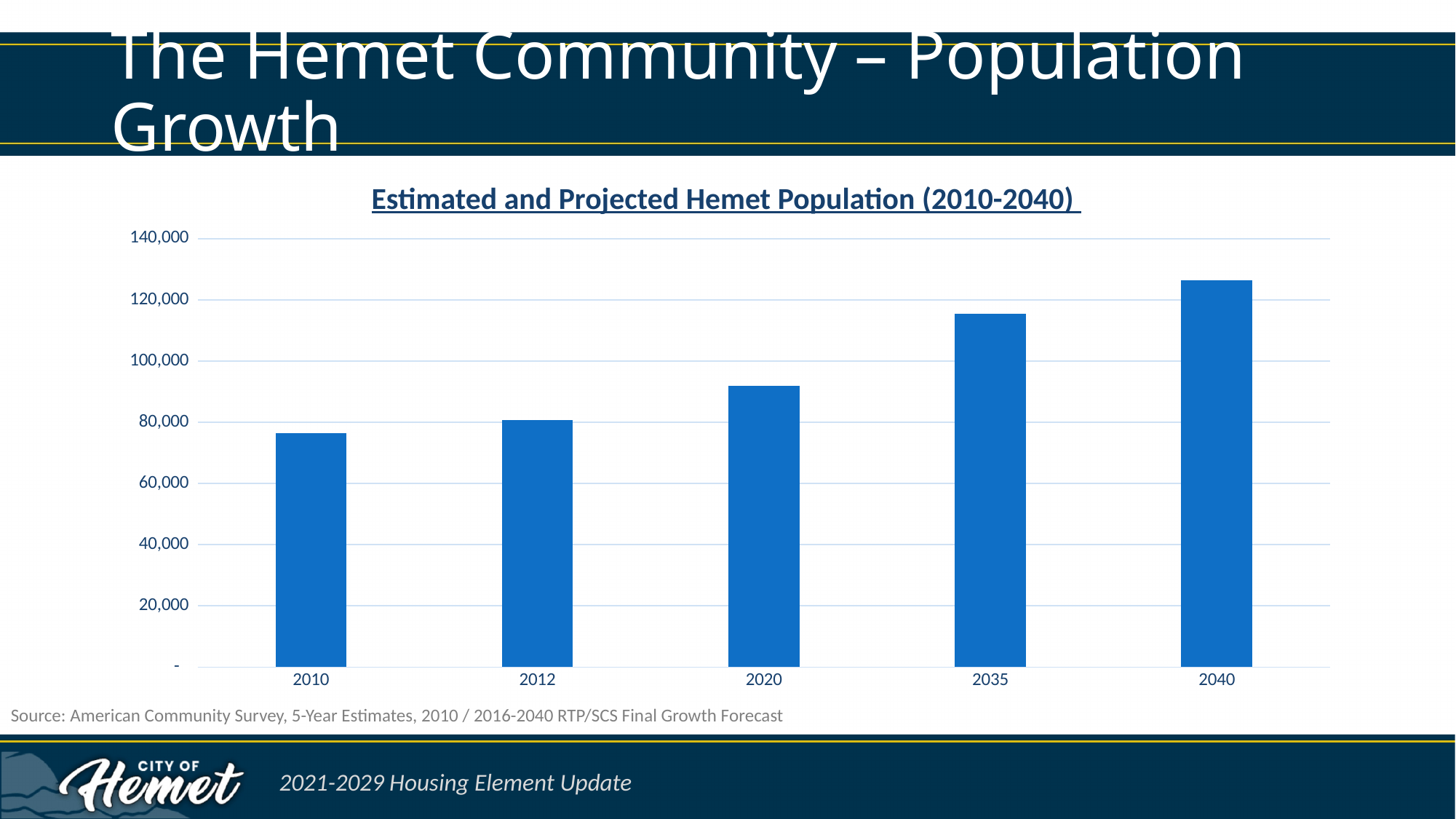
What type of chart is shown on the slide? Bar chart Which year has the highest population value in the chart? 2040 What is the title of the chart? Estimated and Projected Hemet Population (2010-2040) Which year has the lowest population value in the chart? 2010 How many years are shown on the x axis of the chart? 5 Is the population value for 2020 greater or less than 100,000? less Is the population value for 2040 greater or less than 120,000? greater Do the population values rise or fall from 2010 to 2040? Rise Is the population value for 2035 greater or less than 100,000? greater Which year has a larger population value, 2020 or 2035? 2035 What is the highest value shown on the y axis of the chart? 140,000